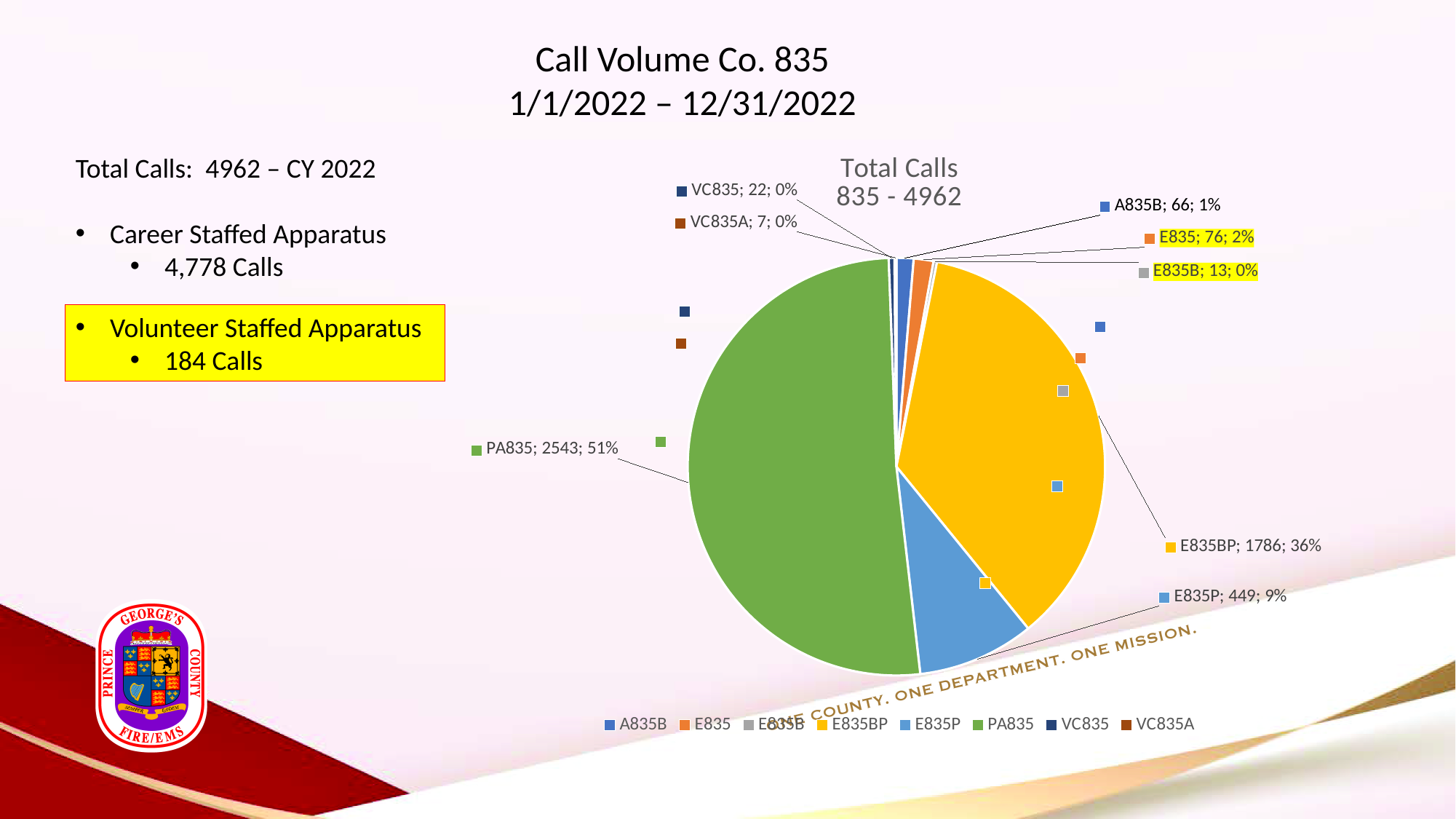
What share of the pie does PA835 represent? 51% How many calls are shown for E835P? 449 Which category has the smallest slice of the pie? VC835A What kind of chart is shown on the slide? pie chart How many calls are shown for VC835A? 7 What is the title of the chart? Total Calls 835 - 4962 What share of the pie does E835P represent? 9% How many categories does the pie chart legend list? 8 Which category has the largest slice of the pie? PA835 What is the difference in calls between PA835 and E835BP? 757 How many calls are shown for E835BP? 1786 How many calls are shown for PA835? 2543